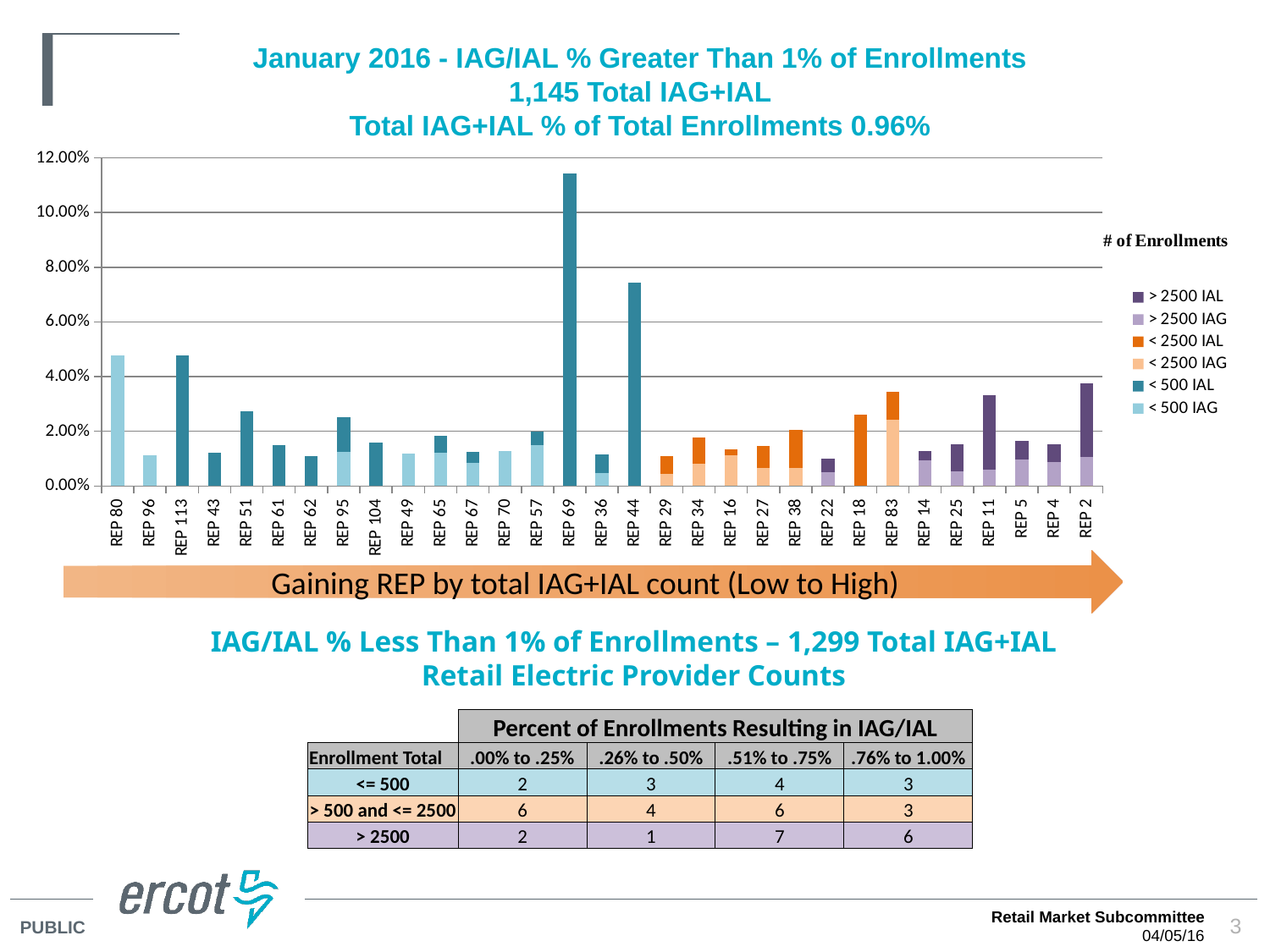
What kind of chart is shown on the slide? Bar chart Is the value for REP 83 greater or less than 2.00%? greater Is the value for REP 80 greater or less than 4.00%? greater Is the value for REP 69 greater or less than 10.00%? greater Which has the larger bar, REP 113 or REP 43? REP 113 Which REP has the highest total bar in the chart? REP 69 What is the title shown above the chart legend? # of Enrollments How many REP categories are plotted along the x axis of the chart? 31 How many series does the chart legend list? 6 Which has the larger bar, REP 69 or REP 44? REP 69